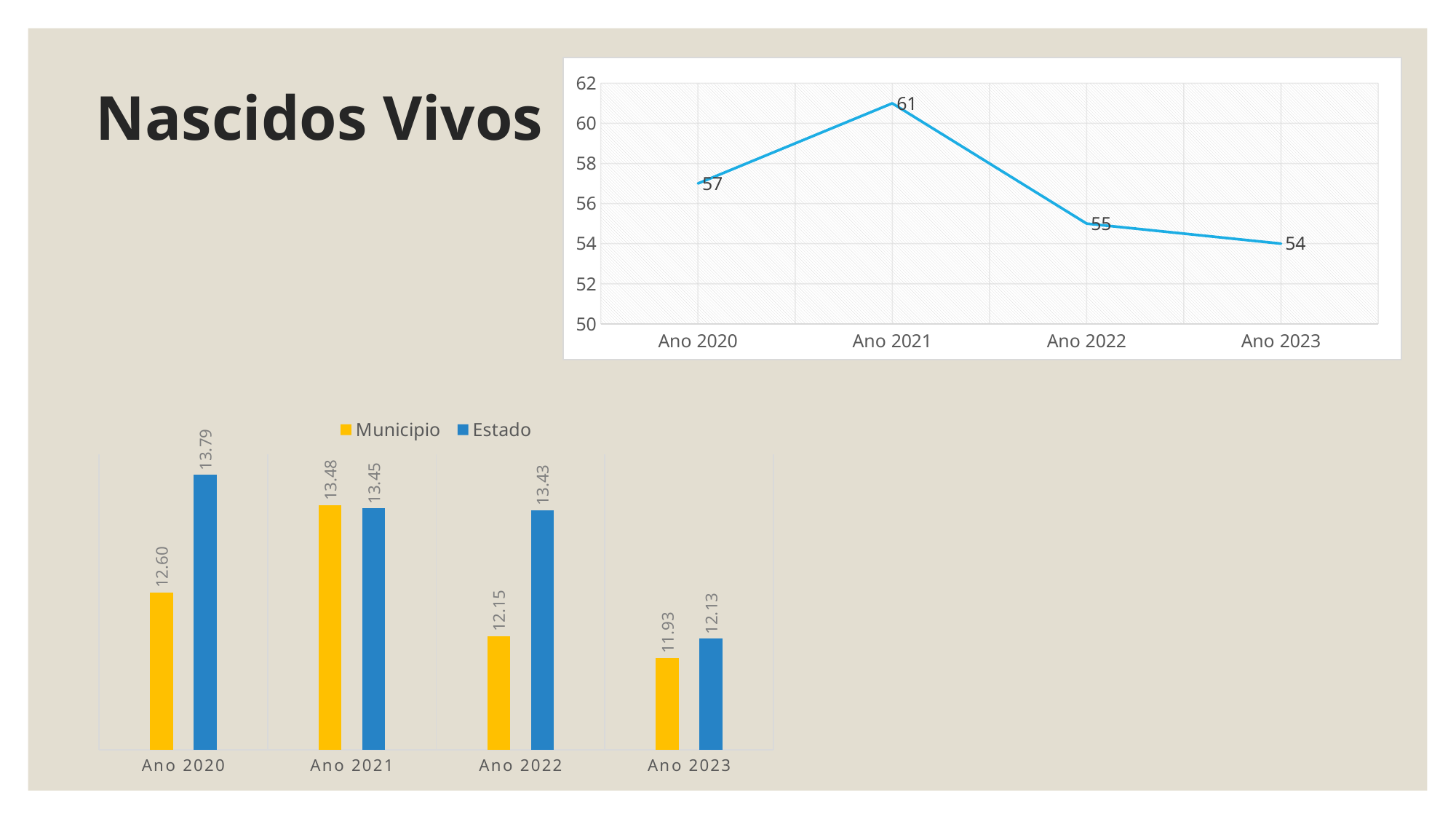
In the bar chart at the bottom left, what is the difference between Estado and Municipio in Ano 2020? 1.19 In the line chart at the top right, which year has the highest value? Ano 2021 In the bar chart at the bottom left, which is larger in Ano 2022: Municipio or Estado? Estado In the line chart at the top right, how many data points are plotted? 4 In the line chart at the top right, what is the value for Ano 2021? 61 In the bar chart at the bottom left, do the Municipio values rise or fall from Ano 2021 to Ano 2023? fall In the bar chart at the bottom left, how many series does the legend list? 2 In the line chart at the top right, what is the value for Ano 2023? 54 In the line chart at the top right, which year has the lowest value? Ano 2023 In the bar chart at the bottom left, what is the value for Estado in Ano 2020? 13.79 In the bar chart at the bottom left, what is the value for Municipio in Ano 2023? 11.93 In the line chart at the top right, what is the difference between the values for Ano 2021 and Ano 2022? 6